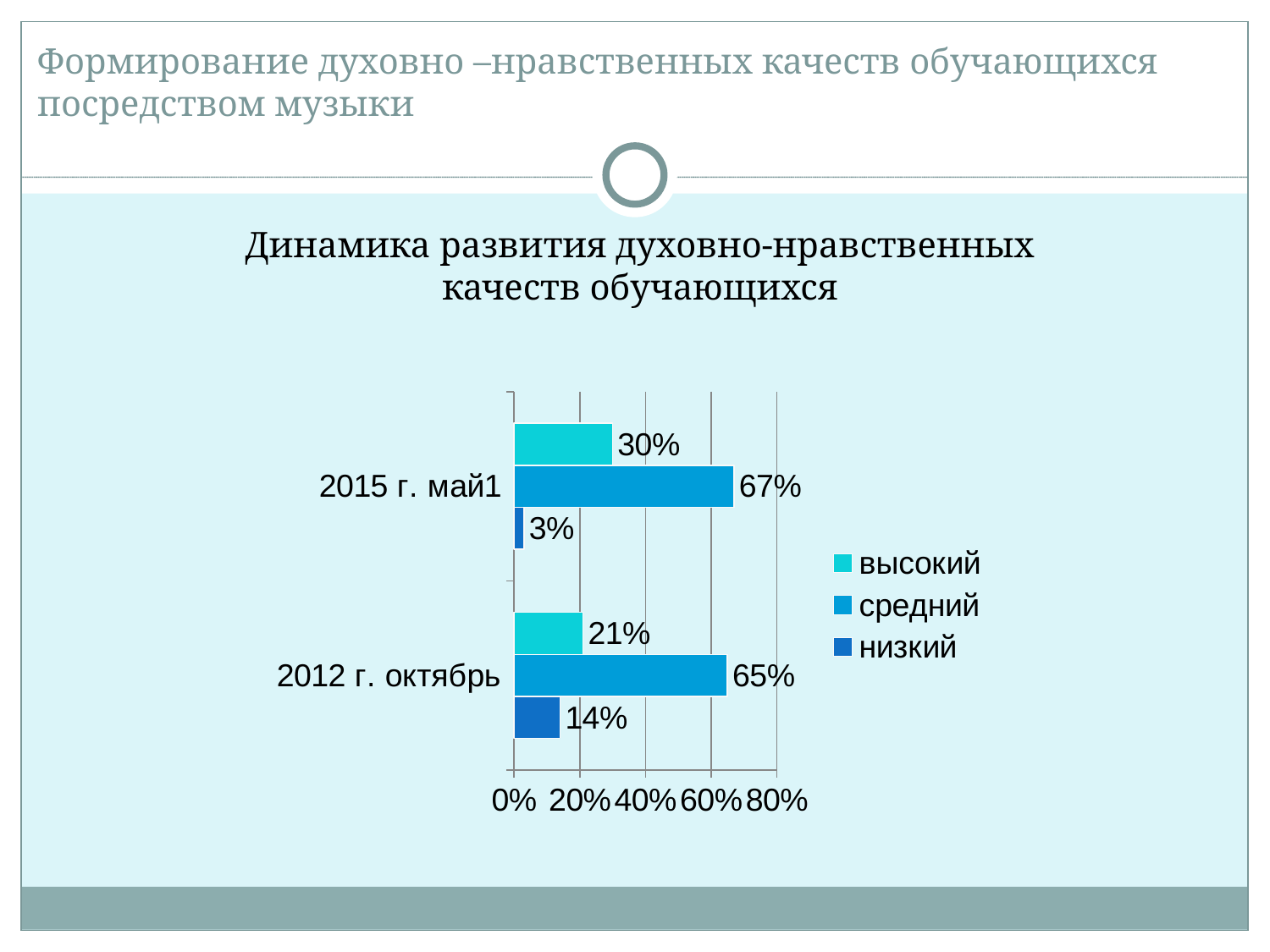
What is the value for высокий in 2015 г. май1? 30% What is the difference between the низкий values for 2012 г. октябрь and 2015 г. май1? 11% Which is larger: средний in 2015 г. май1 or средний in 2012 г. октябрь? средний in 2015 г. май1 What is the value for низкий in 2015 г. май1? 3% What is the value for средний in 2012 г. октябрь? 65% How many series does the legend list? 3 How many categories are shown on the chart? 2 What is the difference between the высокий values for 2015 г. май1 and 2012 г. октябрь? 9% Which series has the lowest value in 2012 г. октябрь? низкий What kind of chart is shown on the slide? bar chart Which series has the highest value in 2015 г. май1? средний What is the value for низкий in 2012 г. октябрь? 14%